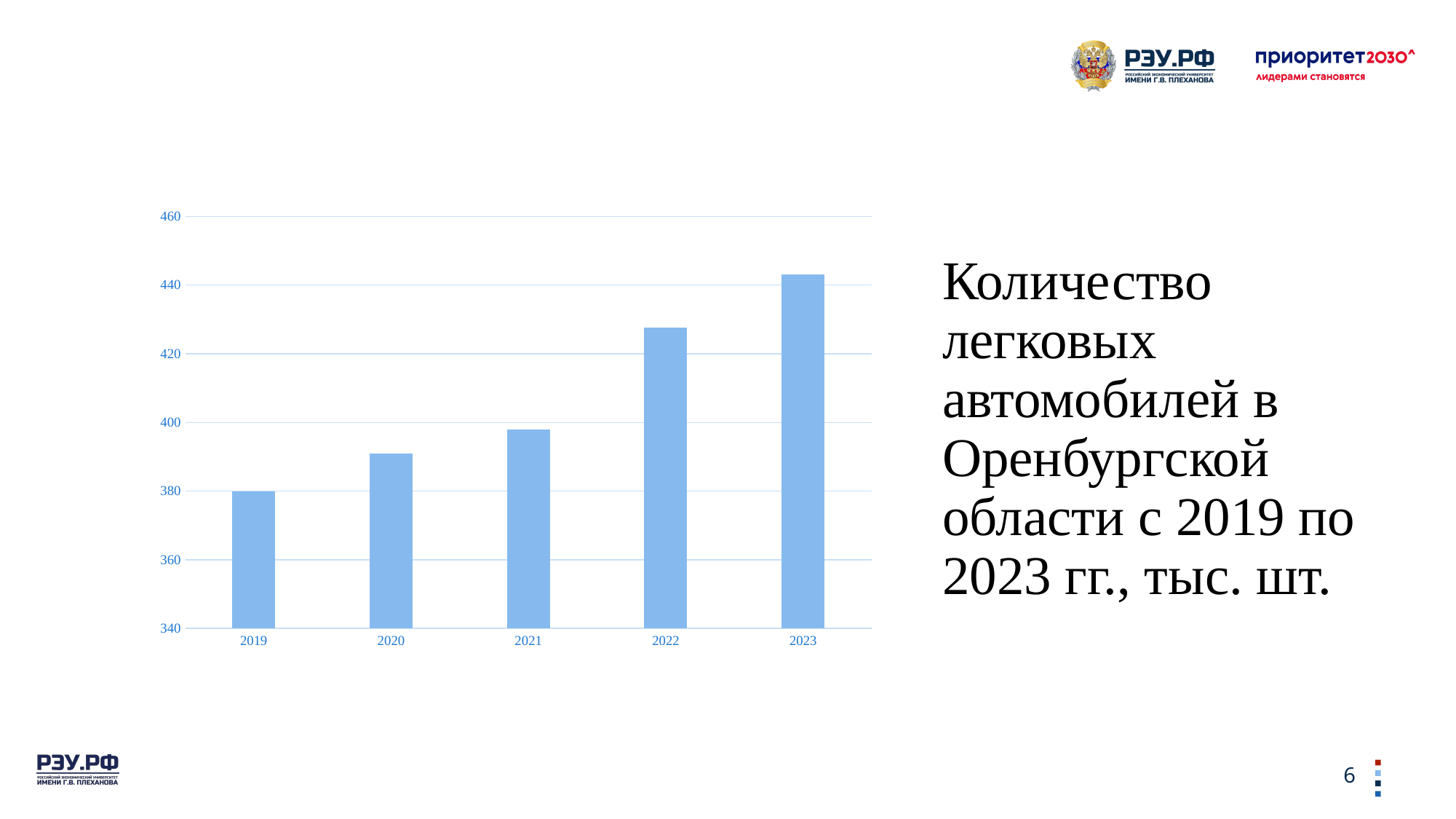
Which is larger, the value for 2022 or the value for 2021? 2022 Is the value for 2020 greater or less than 380? greater Which year has the lowest number of passenger cars? 2019 Which year has the highest number of passenger cars? 2023 Is the value for 2021 greater or less than 380? greater What region does the chart title say the passenger car data is for? Оренбургская область Is the value for 2022 greater or less than 420? greater Do the values rise or fall from 2019 to 2023? rise What kind of chart is shown on the slide? bar chart How many years are plotted on the chart? 5